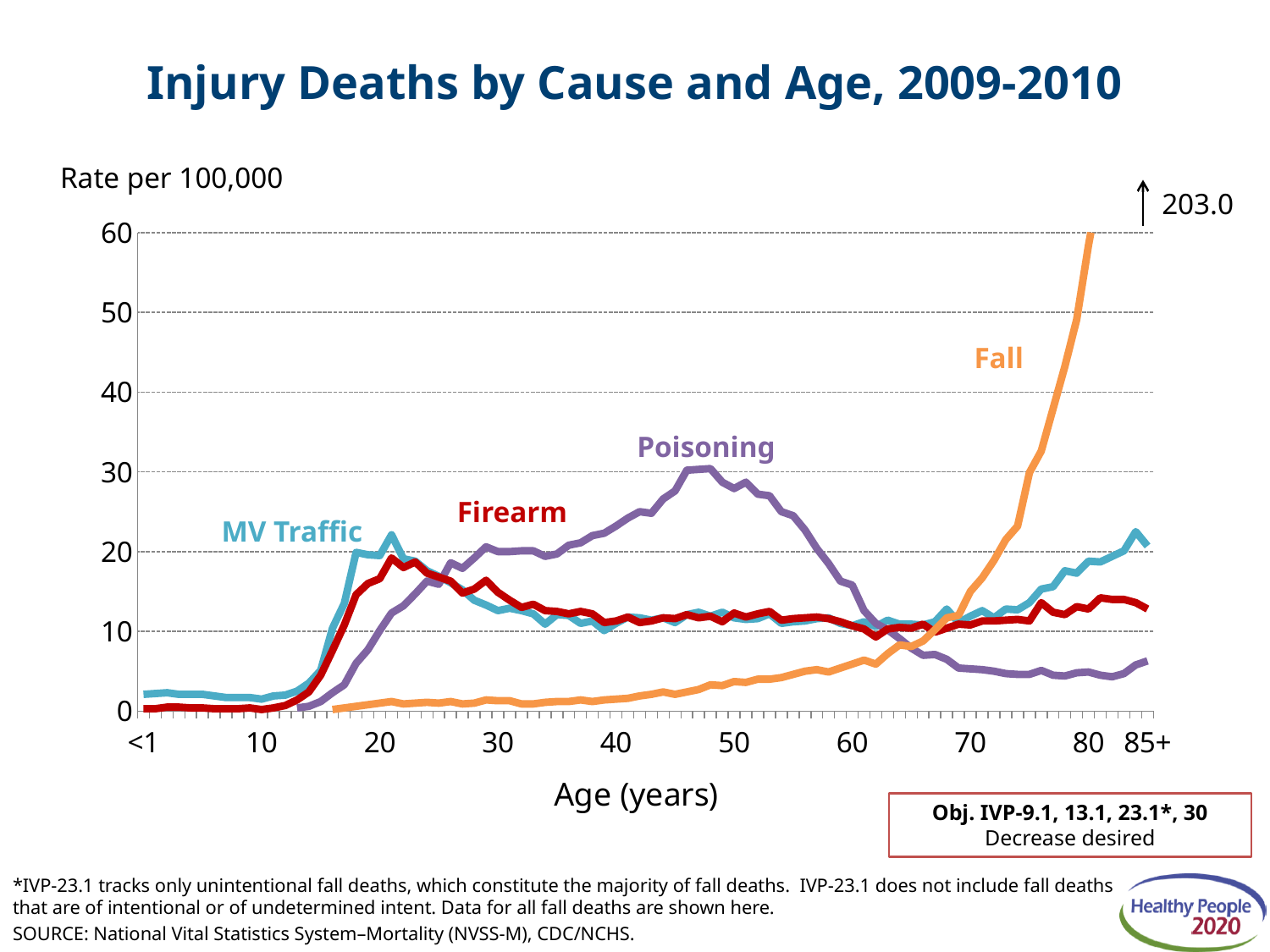
What kind of chart is shown on the slide? line chart At age 50, which cause has the higher death rate, Poisoning or Firearm? Poisoning Is the Poisoning death rate at age 50 greater or less than 20? greater Which cause has the highest injury death rate at age 85+? Fall What is the title of the chart? Injury Deaths by Cause and Age, 2009-2010 How many causes of injury death are plotted as lines on the chart? 4 What is the rate per 100,000 for Fall deaths at age 85+, as printed above the chart? 203.0 Which cause has the lowest injury death rate at age 85+? Poisoning What is the label on the x axis of the chart? Age (years) Is the MV Traffic death rate at age 40 greater or less than 20? less Is the Fall death rate at age 60 greater or less than 10? less Does the Fall death rate rise or fall as age increases from 60 to 85+? rise